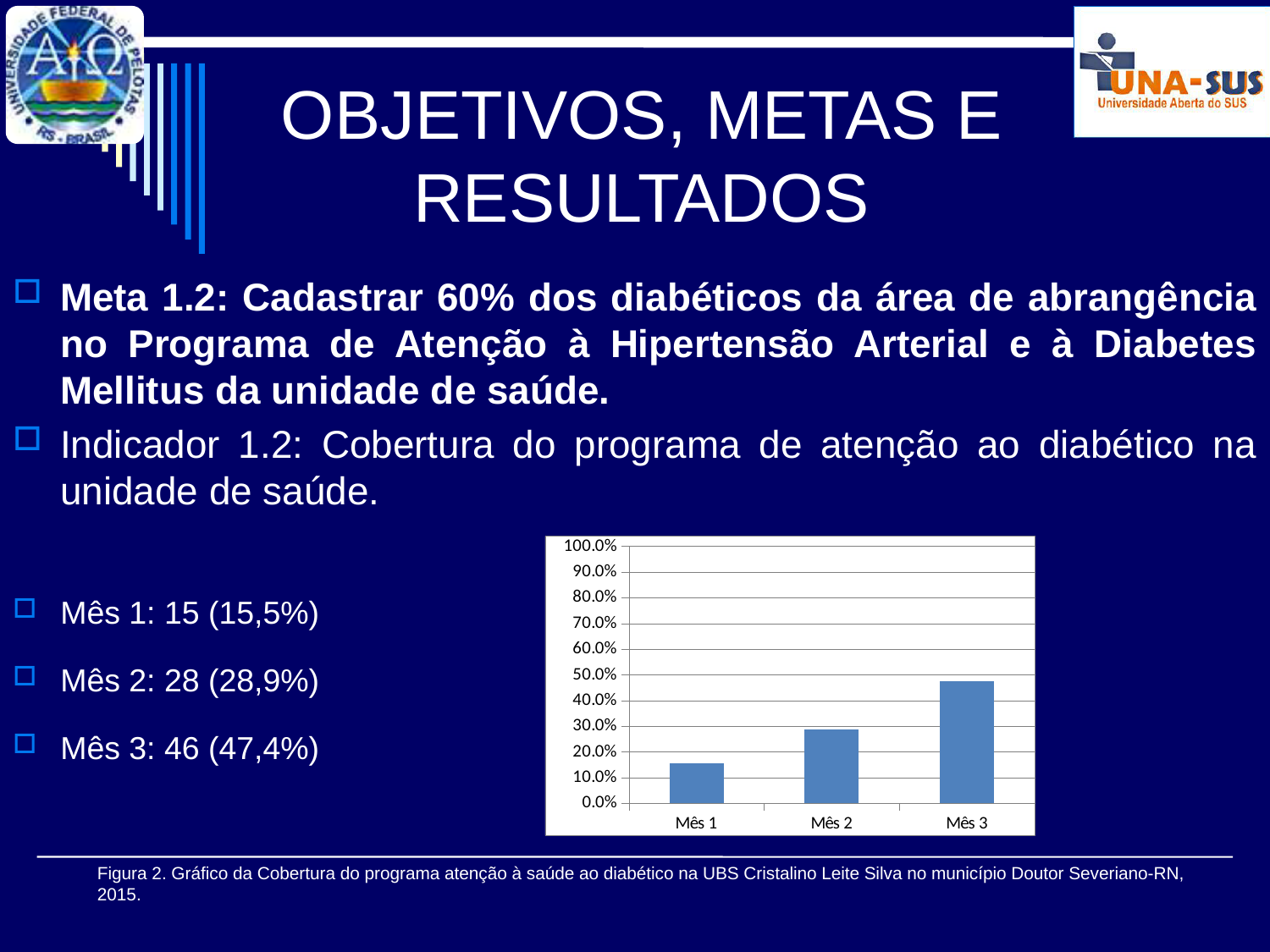
How many categories (months) are plotted on the x axis of the chart? 3 Which month has the highest bar in the chart? Mês 3 Is the value for Mês 2 greater or less than 20.0%? greater Which is larger, the bar for Mês 2 or the bar for Mês 1? Mês 2 Do the values rise or fall from Mês 1 to Mês 3? rise Is the value for Mês 3 greater or less than 50.0%? less Is the value for Mês 1 greater or less than 20.0%? less Which month has the lowest bar in the chart? Mês 1 What colour are the bars in the chart? blue What is the maximum value shown on the chart's y axis? 100.0% What kind of chart is shown on the slide? bar chart